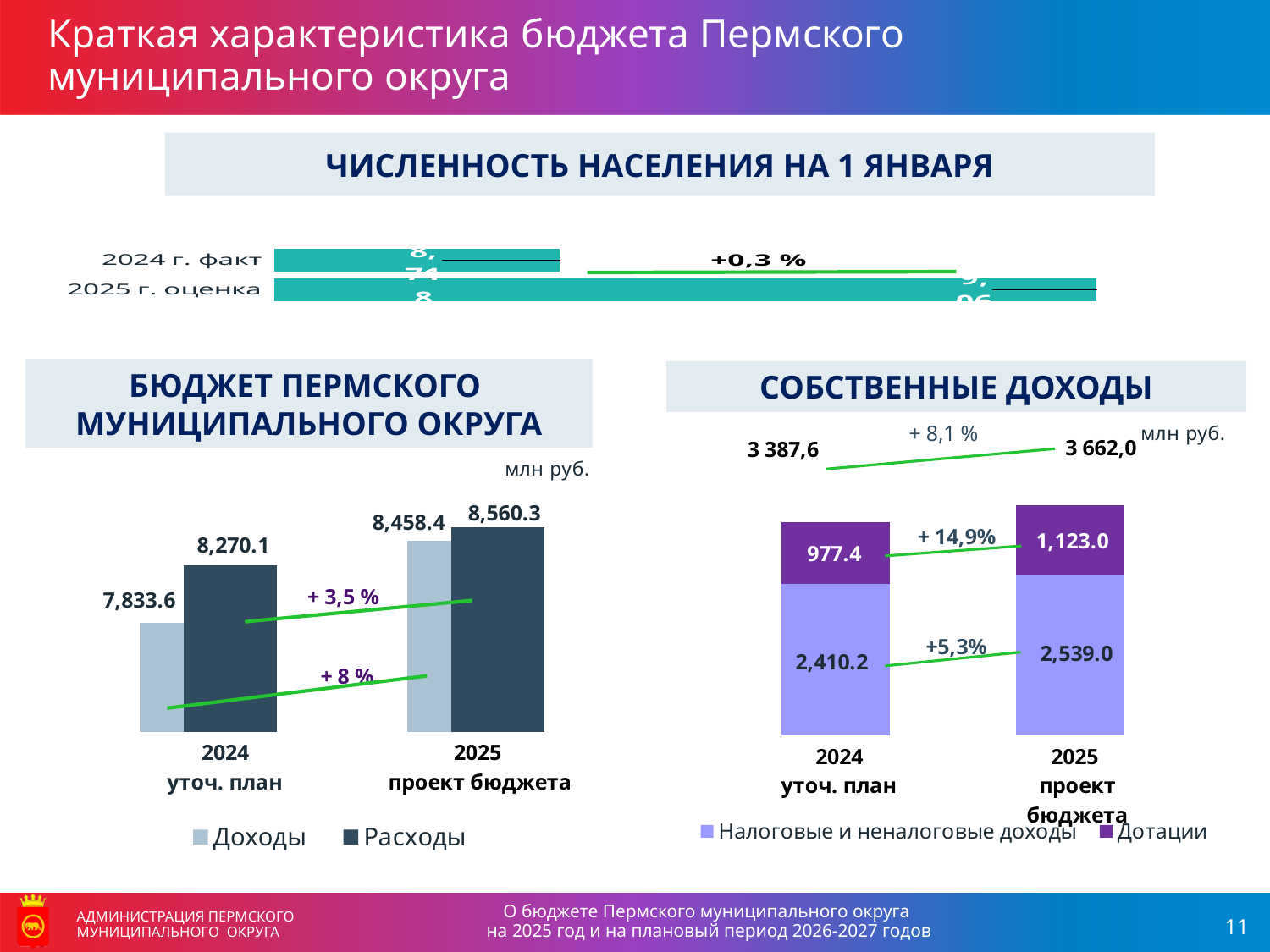
In the 'Бюджет Пермского муниципального округа' chart, do the Доходы values rise or fall from 2024 to 2025? rise In the 'Собственные доходы' chart, what is the total of the stacked bar for 2024 уточ. план? 3 387,6 What kind of chart is the 'Собственные доходы' chart? stacked bar chart In the 'Бюджет Пермского муниципального округа' chart, what is the value of Расходы for 2025 проект бюджета? 8,560.3 In the 'Бюджет Пермского муниципального округа' chart, what is the value of Доходы for 2024 уточ. план? 7,833.6 In the 'Собственные доходы' chart, what percentage growth is shown between the 2024 and 2025 totals? + 8,1 % In the 'Собственные доходы' chart, what is the value of Налоговые и неналоговые доходы for 2024 уточ. план? 2,410.2 In the 'Бюджет Пермского муниципального округа' chart, how many series does the legend list? 2 In the 'Собственные доходы' chart, what is the difference in Дотации between 2025 проект бюджета and 2024 уточ. план? 145.6 In the 'Бюджет Пермского муниципального округа' chart, which is larger for 2025 проект бюджета, Доходы or Расходы? Расходы In the 'Собственные доходы' chart, what is the value of Дотации for 2025 проект бюджета? 1,123.0 In the 'Бюджет Пермского муниципального округа' chart, what is the difference between Расходы and Доходы for 2024 уточ. план? 436.5